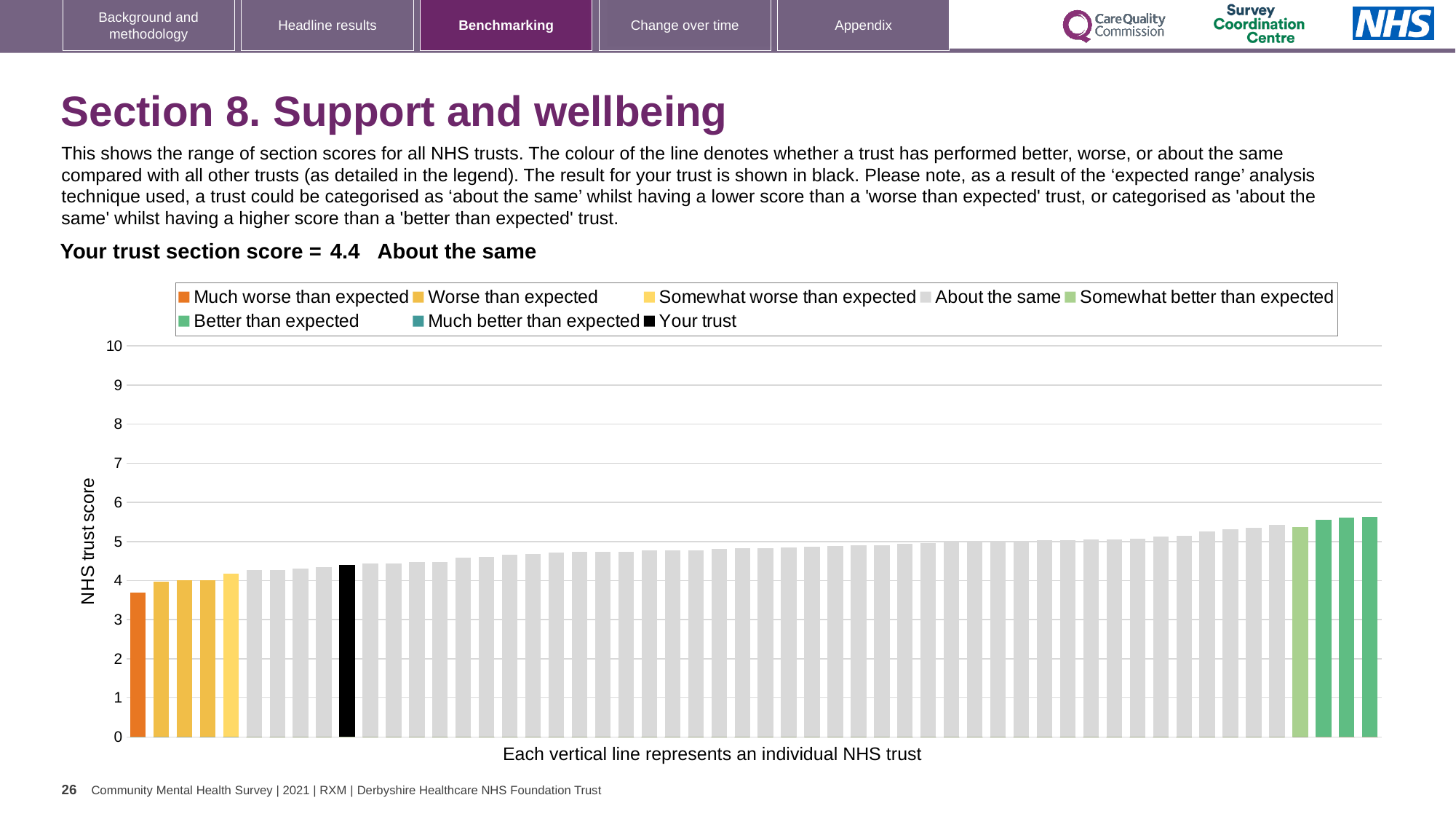
Do the bar values rise or fall from left to right across the chart? rise Which legend category does the lowest bar on the chart belong to? Much worse than expected Is the value of the black bar (your trust) greater or less than 5? less Is the value of the lowest bar (the orange one) greater or less than 4? less How many entries does the chart legend list? 8 How is your trust's score categorised compared with other trusts? About the same Is the black bar for your trust higher or lower than the orange bar? higher Is the value of the tallest bar greater or less than 5? greater What is the label on the vertical axis of the chart? NHS trust score What kind of chart is shown on the slide? Bar chart What is the section score for your trust, as printed on the slide? 4.4